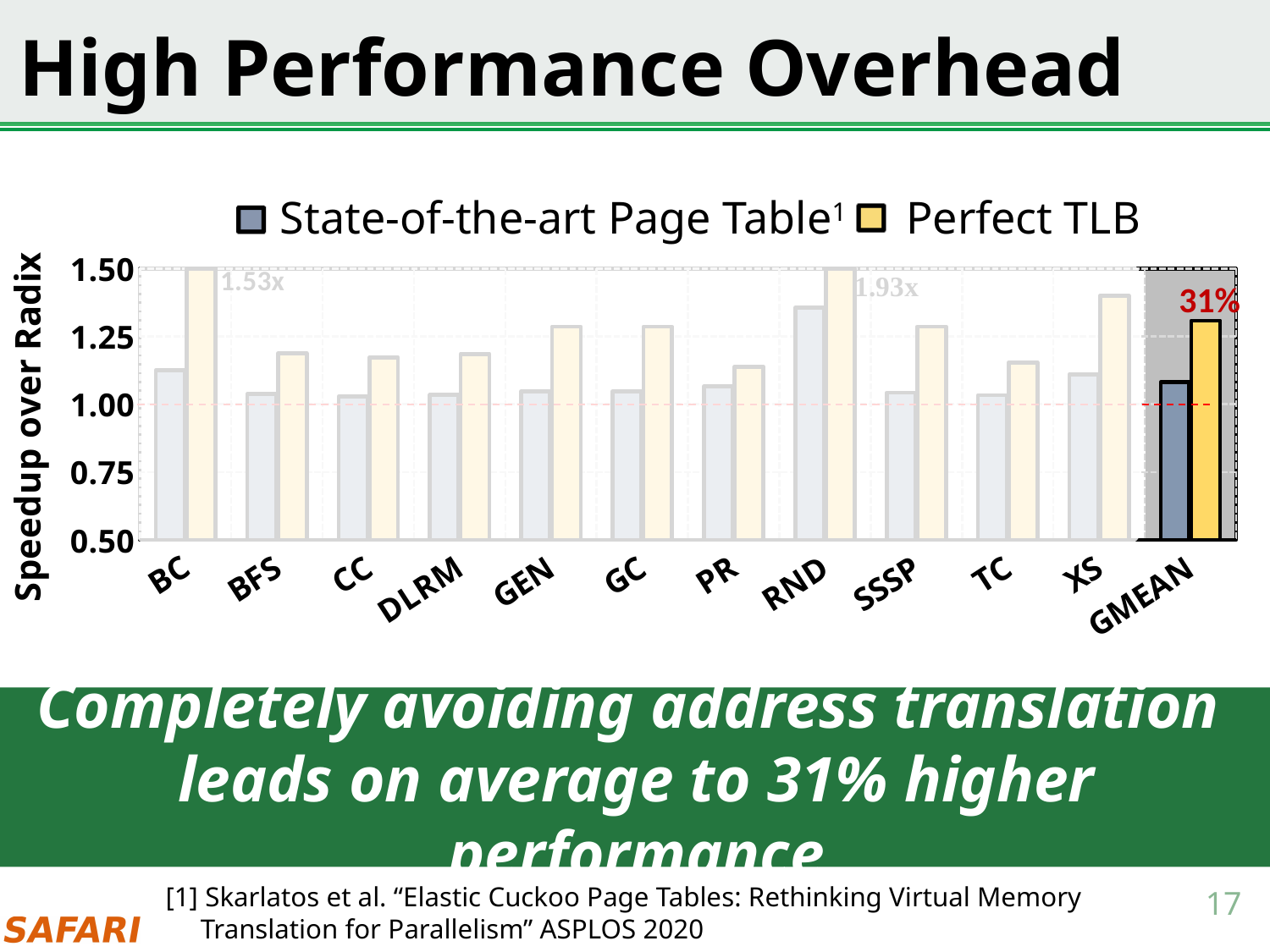
For GEN, which series has the larger value: State-of-the-art Page Table or Perfect TLB? Perfect TLB What is the label of the y axis? Speedup over Radix How many categories are shown along the x axis? 12 What is the Perfect TLB speedup for RND? 1.93x What is the Perfect TLB speedup for BC? 1.53x Is the Perfect TLB value for PR greater or less than 1.25? less Which category has the highest Perfect TLB speedup? RND Is the State-of-the-art Page Table value for RND greater or less than 1.25? greater Is the Perfect TLB value for XS greater or less than 1.25? greater What kind of chart is shown on the slide? bar chart What is the difference between the Perfect TLB speedup for RND and for BC? 0.40x How many series does the legend list? 2